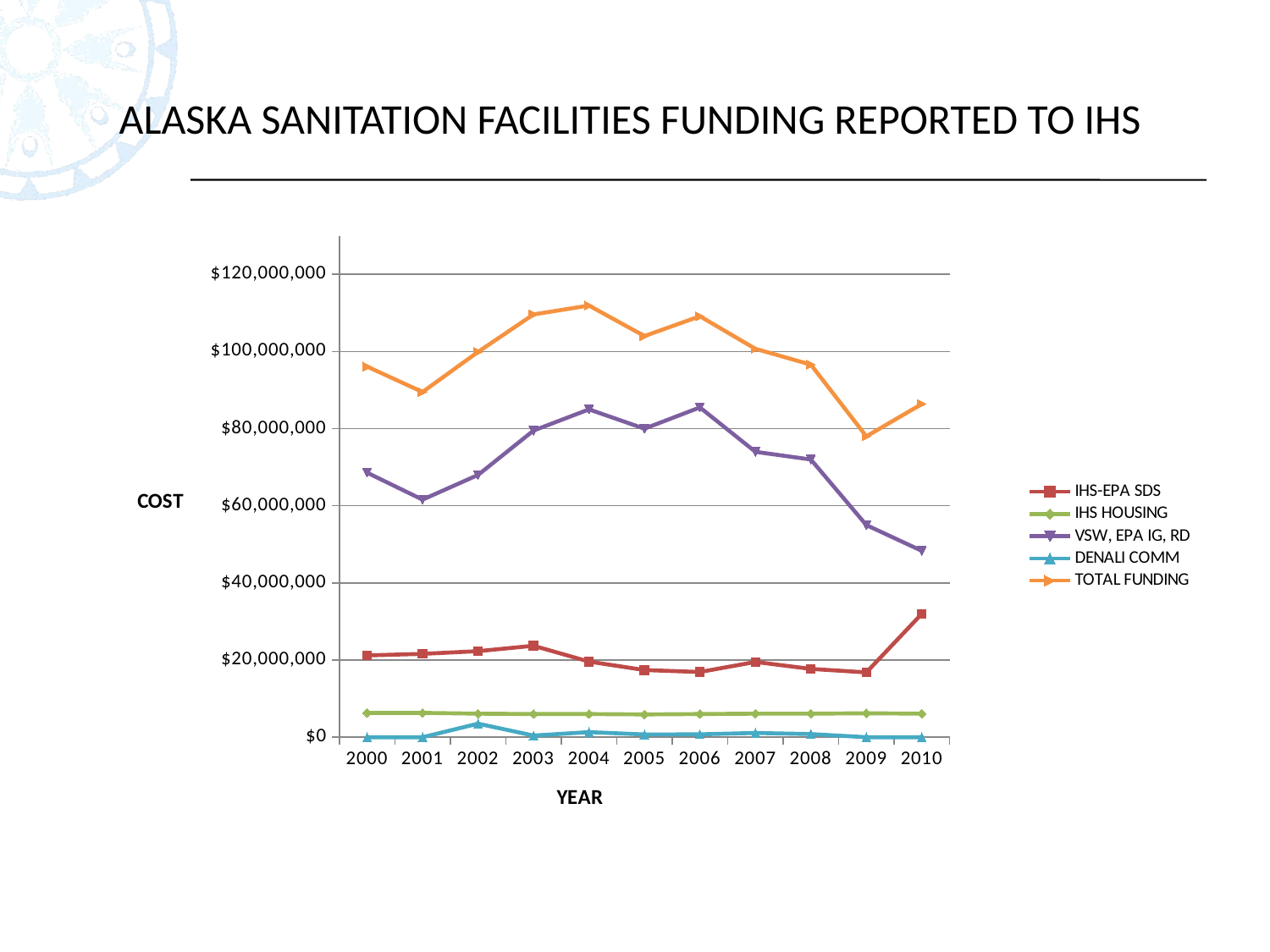
How many series does the legend list? 5 In which year is IHS-EPA SDS highest? 2010 What kind of chart is shown on the slide? line chart Which is larger in 2005, IHS HOUSING or DENALI COMM? IHS HOUSING In which year is TOTAL FUNDING lowest? 2009 Is the value for TOTAL FUNDING in 2004 greater or less than $100,000,000? greater Is the value for TOTAL FUNDING in 2001 greater or less than $100,000,000? less Is the value for VSW, EPA IG, RD in 2010 greater or less than $60,000,000? less Does TOTAL FUNDING rise or fall from 2006 to 2009? fall How many years are plotted along the x axis? 11 In which year is VSW, EPA IG, RD lowest? 2010